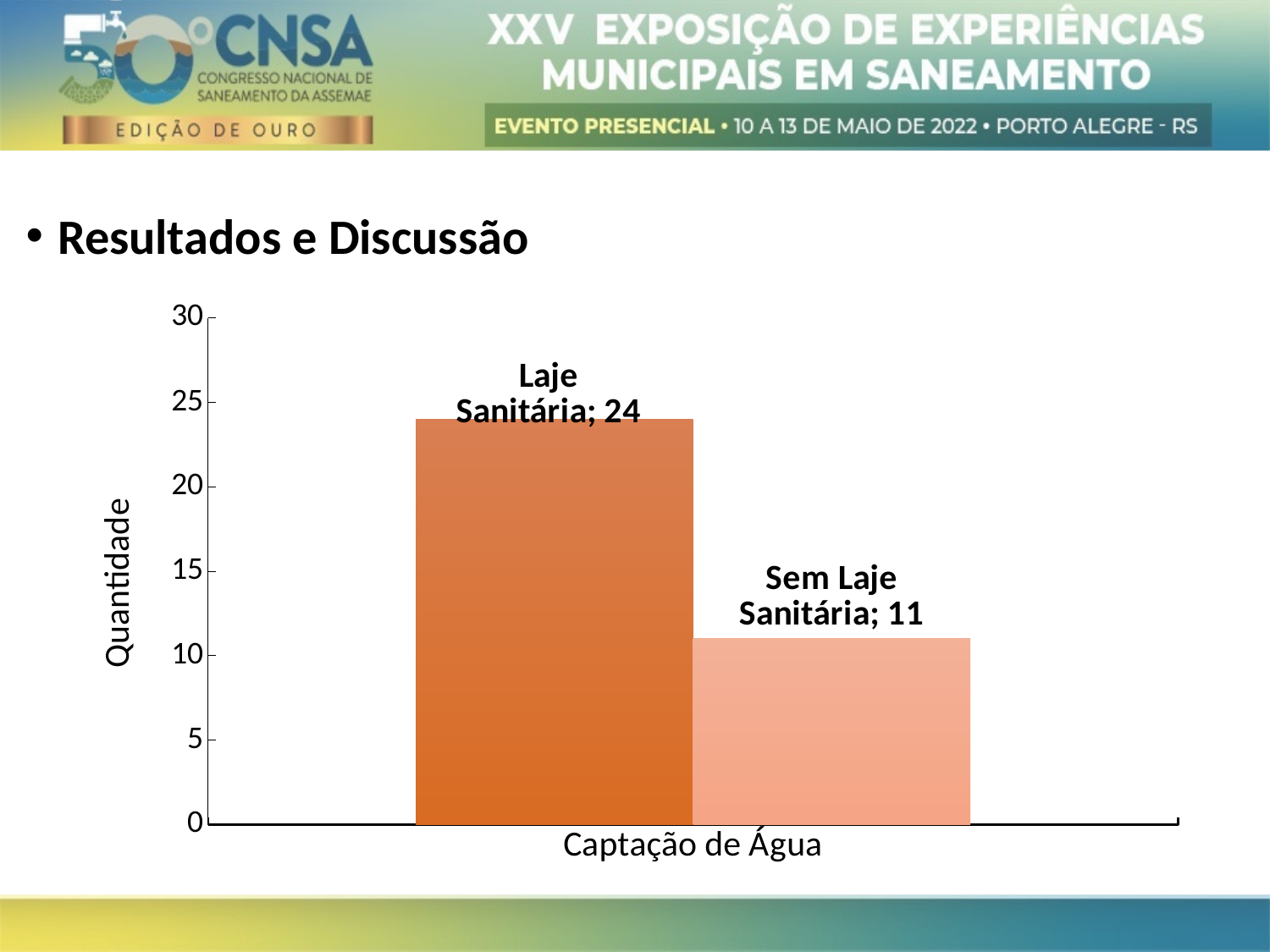
Which category has the highest value? Laje Sanitária Is the value for Laje Sanitária greater or less than 20? greater Which is larger, the value for Laje Sanitária or the value for Sem Laje Sanitária? Laje Sanitária What kind of chart is shown on the slide? bar chart What is the value for Laje Sanitária? 24 Which category has the lowest value? Sem Laje Sanitária Is the value for Sem Laje Sanitária greater or less than 15? less What is the value for Sem Laje Sanitária? 11 What is the label of the horizontal axis? Captação de Água What is the difference between the values for Laje Sanitária and Sem Laje Sanitária? 13 How many bars are plotted in the chart? 2 What is the label of the vertical axis? Quantidade